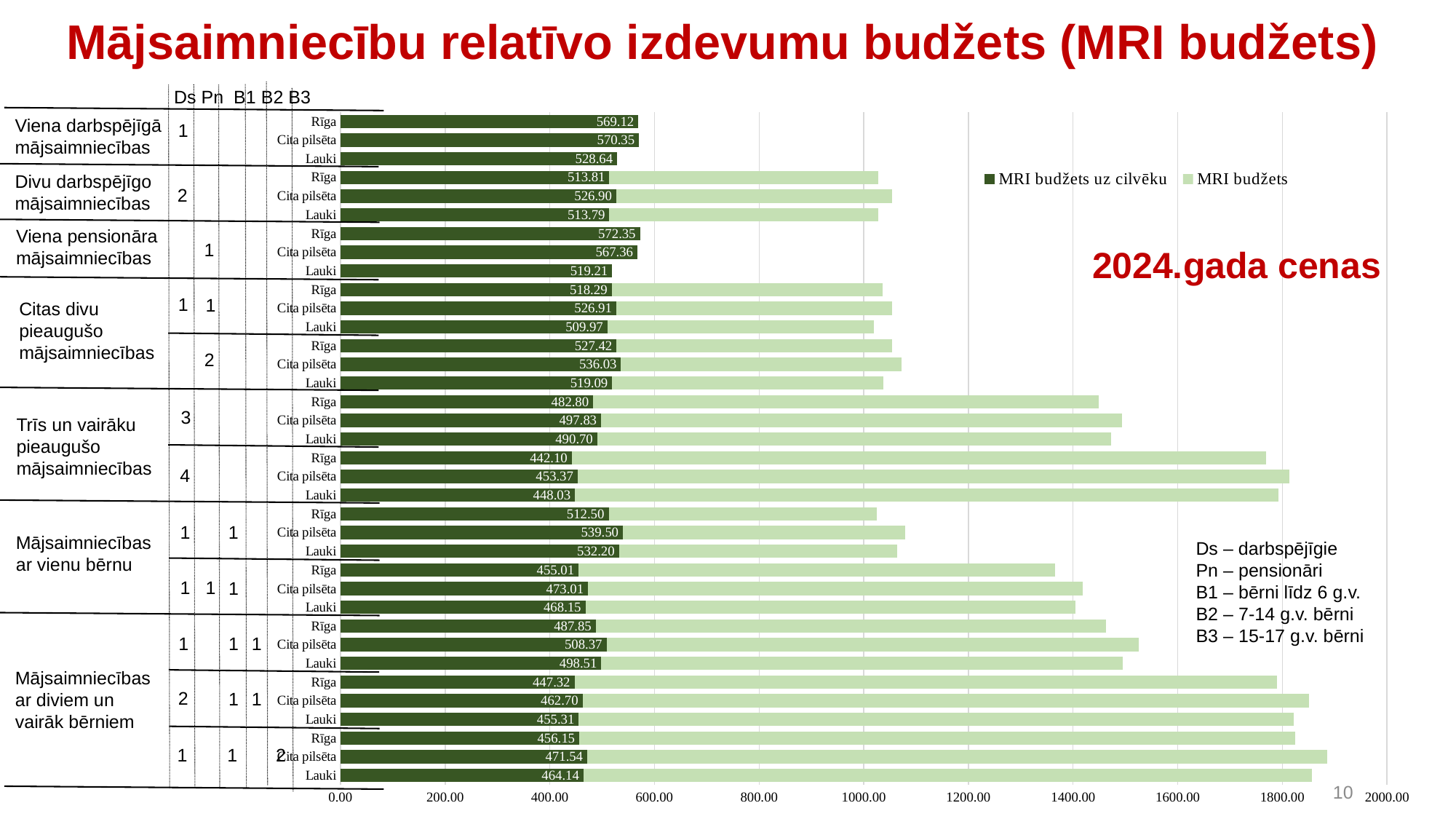
What are the two series names shown in the legend? MRI budžets uz cilvēku; MRI budžets How many series does the legend list? 2 What is the MRI budžets uz cilvēku value for Lauki in the Viena pensionāra mājsaimniecības group? 519.21 In the Viena darbspējīgā mājsaimniecības group, what is the difference between the MRI budžets uz cilvēku values for Cita pilsēta and Rīga? 1.23 Is the MRI budžets value (light green bar) for Rīga in the Trīs un vairāku pieaugušo mājsaimniecības group with 3 Ds greater or less than 1200.00? greater In the Divu darbspējīgo mājsaimniecības group, which has the larger MRI budžets uz cilvēku value: Cita pilsēta or Lauki? Cita pilsēta What kind of chart is shown on the slide? Bar chart Which bar has the highest MRI budžets uz cilvēku value on the chart? Rīga, Viena pensionāra mājsaimniecības (572.35) Is the MRI budžets value (light green bar) for Rīga in the Mājsaimniecības ar vienu bērnu group with 1 Ds and 1 B1 greater or less than 1200.00? less What is the MRI budžets uz cilvēku value for Cita pilsēta in the Trīs un vairāku pieaugušo mājsaimniecības group with 4 Ds? 453.37 What is the MRI budžets uz cilvēku value for Rīga in the Viena darbspējīgā mājsaimniecības group? 569.12 Which bar has the lowest MRI budžets uz cilvēku value on the chart? Rīga, Trīs un vairāku pieaugušo mājsaimniecības with 4 Ds (442.10)